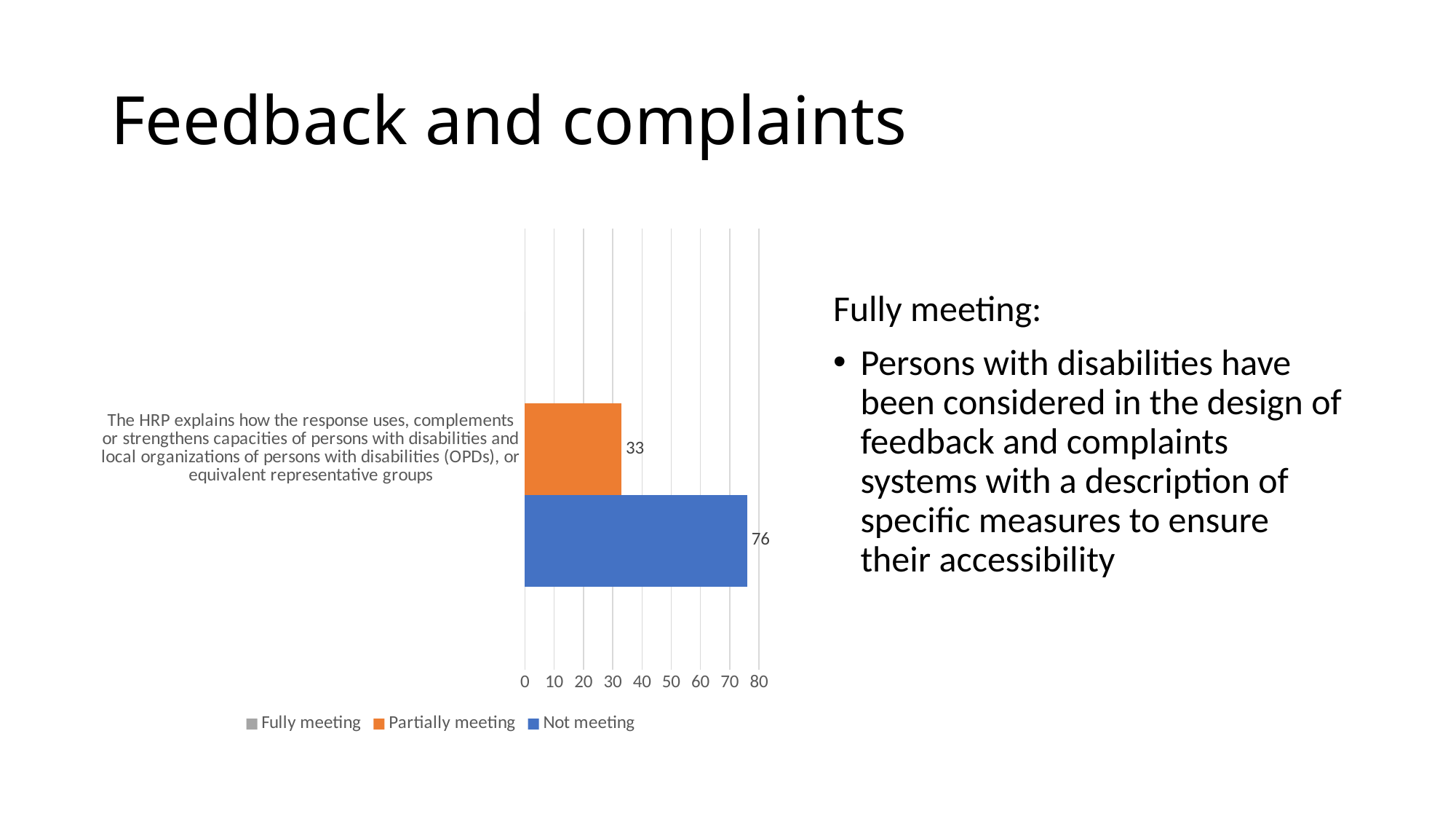
What is the highest value shown on the x axis? 80 What is the difference between the Not meeting value and the Partially meeting value? 43 Which series has the highest value, Partially meeting or Not meeting? Not meeting How many series does the legend list? 3 How many categories are shown on the chart? 1 What is the value for Partially meeting? 33 What colour is the Not meeting bar? Blue Is the value for Partially meeting greater or less than 40? less What kind of chart is shown on the slide? Bar chart What is the value for Not meeting? 76 Is the value for Not meeting greater or less than 70? greater Which is larger, the value for Partially meeting or the value for Not meeting? Not meeting